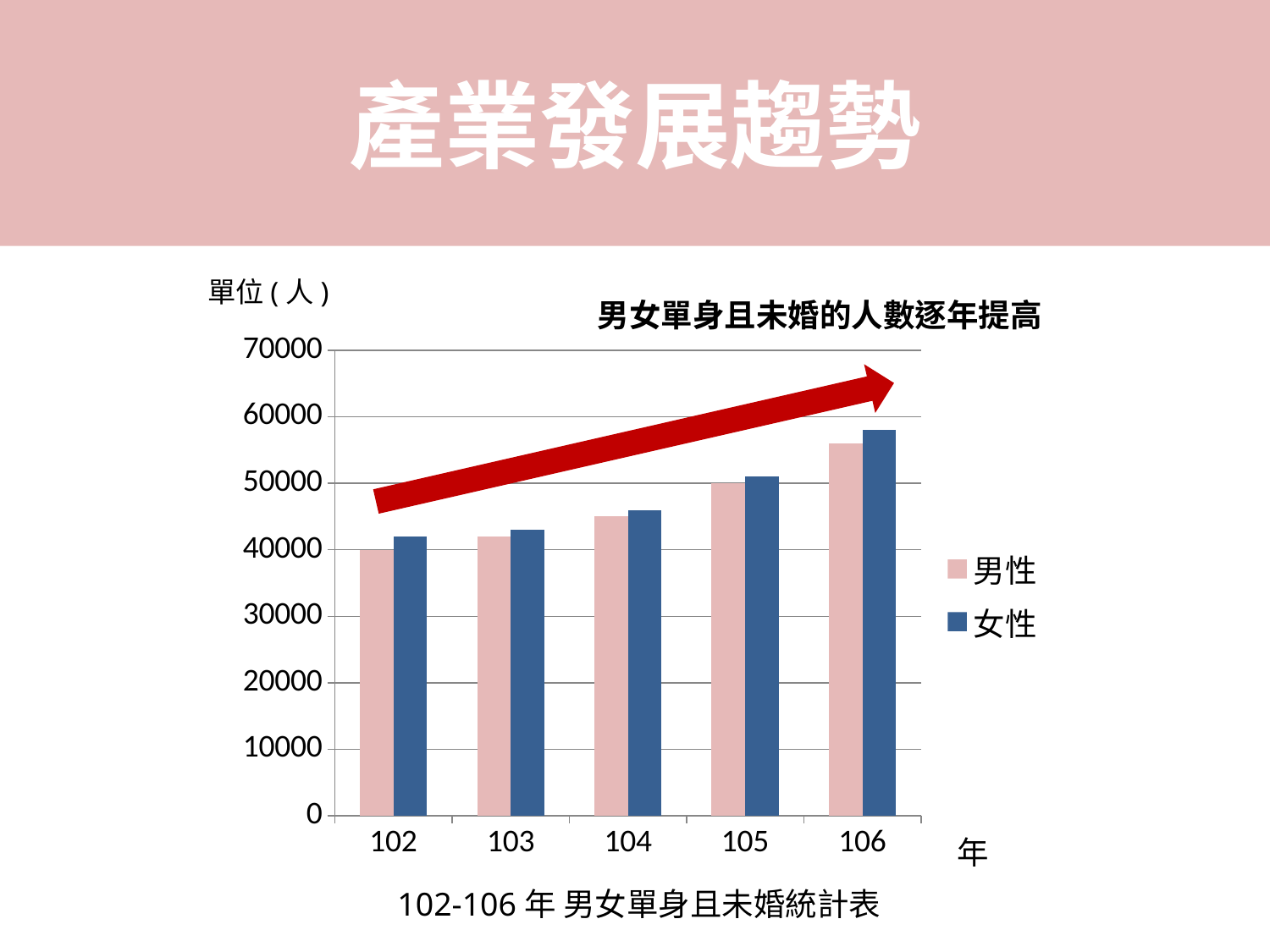
Which year has the highest value for 女性? 106 Which year has the lowest value for 男性? 102 What is the value for 男性 in year 102? 40000 What kind of chart is shown on the slide? bar chart What are the two legend entries of the chart? 男性, 女性 Do the values for 男性 rise or fall from year 102 to year 106? rise Which is larger in year 106: the value for 男性 or the value for 女性? 女性 What is the caption printed below the chart? 102-106 年 男女單身且未婚統計表 Is the value for 男性 in year 103 greater or less than 50000? less How many series does the legend list? 2 Is the value for 女性 in year 106 greater or less than 50000? greater How many years are shown on the x axis? 5